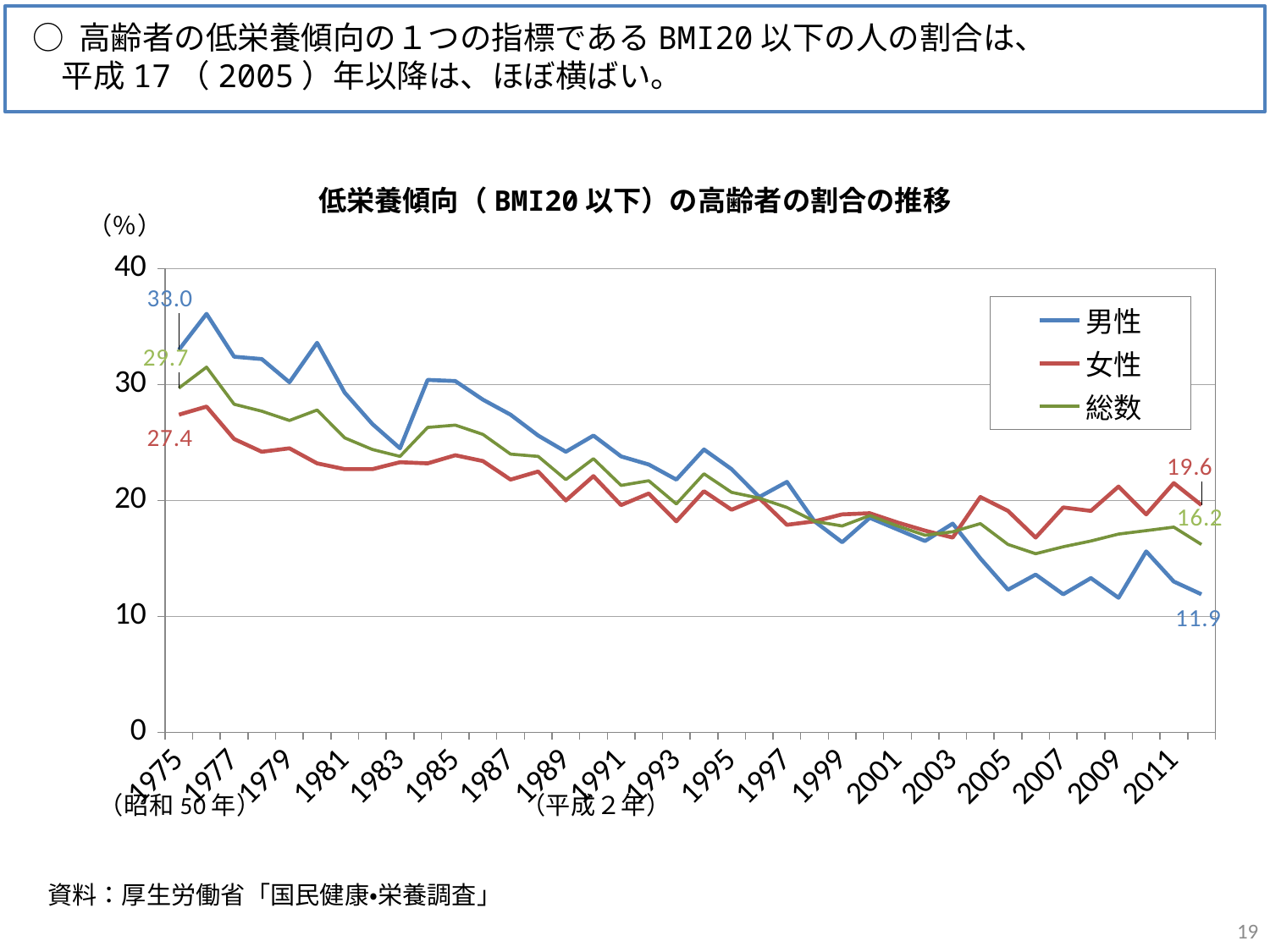
What is the difference between the final labelled values for 女性 (19.6) and 男性 (11.9)? 7.7 How many series does the legend list? 3 What is the value for 女性 in 1975? 27.4 What is the final labelled value for 女性 at the right end of the chart? 19.6 What is the value for 男性 at the start of the series in 1975? 33.0 Which series has the lowest final labelled value at the right end of the chart? 男性 Which series has the highest value in 1975? 男性 What is the value for 総数 in 1975? 29.7 What is the final labelled value for 総数 at the right end of the chart? 16.2 Is the value for 男性 in 2005 greater or less than 20? less What is the difference between the 男性 and 女性 values in 1975? 5.6 What is the final labelled value for 男性 at the right end of the chart? 11.9